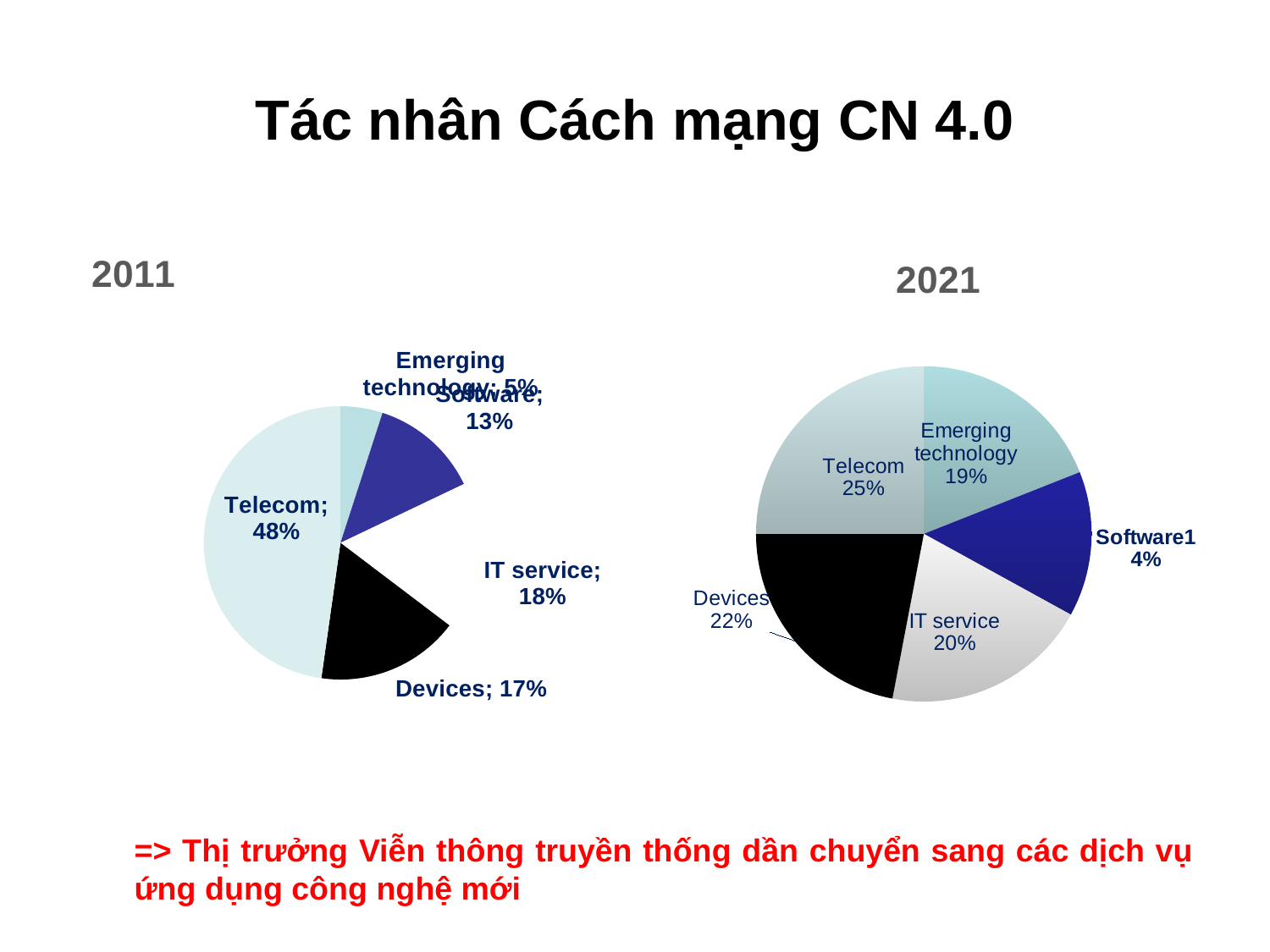
In the 2011 pie chart, which category has the smallest share? Emerging technology In the 2021 pie chart, which is larger, Devices or IT service? Devices In the 2011 pie chart, what share does Telecom have? 48% In the 2021 pie chart, what share does Telecom have? 25% By how many percentage points did Telecom's share fall from the 2011 chart to the 2021 chart? 23 percentage points In the 2021 pie chart, which category has the largest share? Telecom In the 2021 pie chart, what is the value for Emerging technology? 19% How many categories are shown in the 2011 pie chart? 5 In the 2011 pie chart, what is the value for IT service? 18% In the 2021 pie chart, what is the value for Devices? 22% In the 2011 pie chart, which category has the largest share? Telecom What type of chart is used for the 2011 and 2021 data? Pie chart